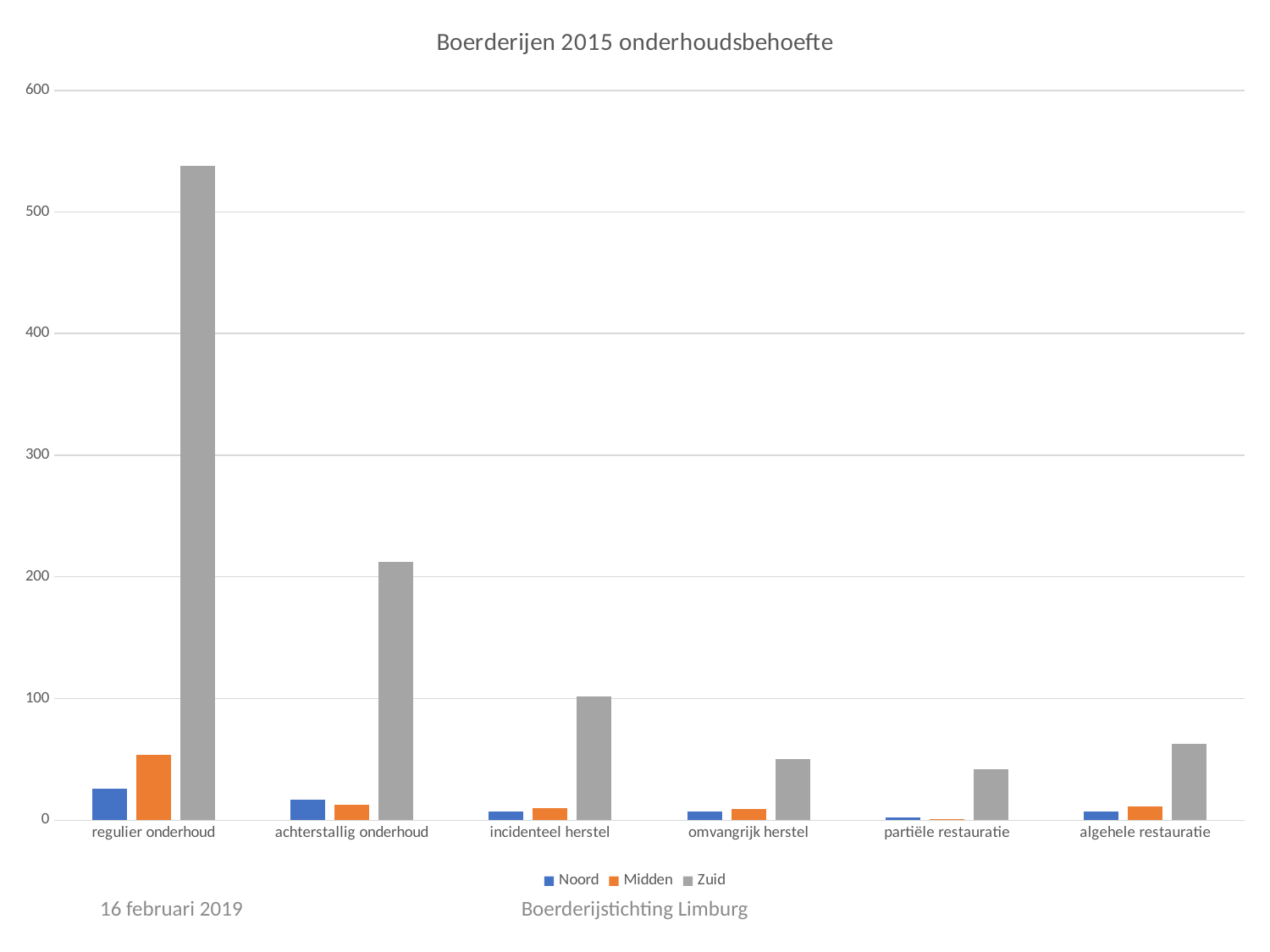
Which series is shown in grey? Zuid In regulier onderhoud, which is larger: Noord or Midden? Midden Is the value for Zuid in regulier onderhoud greater or less than 500? greater Which is larger: Zuid in regulier onderhoud or Zuid in achterstallig onderhoud? Zuid in regulier onderhoud Is the value for Midden in regulier onderhoud greater or less than 100? less Is the value for Zuid in achterstallig onderhoud greater or less than 300? less Which category has the highest value for Zuid? regulier onderhoud Which category has the highest value for Midden? regulier onderhoud What type of chart is shown on the slide? bar chart How many categories are shown on the x axis? 6 How many series does the legend list? 3 What is the title of the chart? Boerderijen 2015 onderhoudsbehoefte